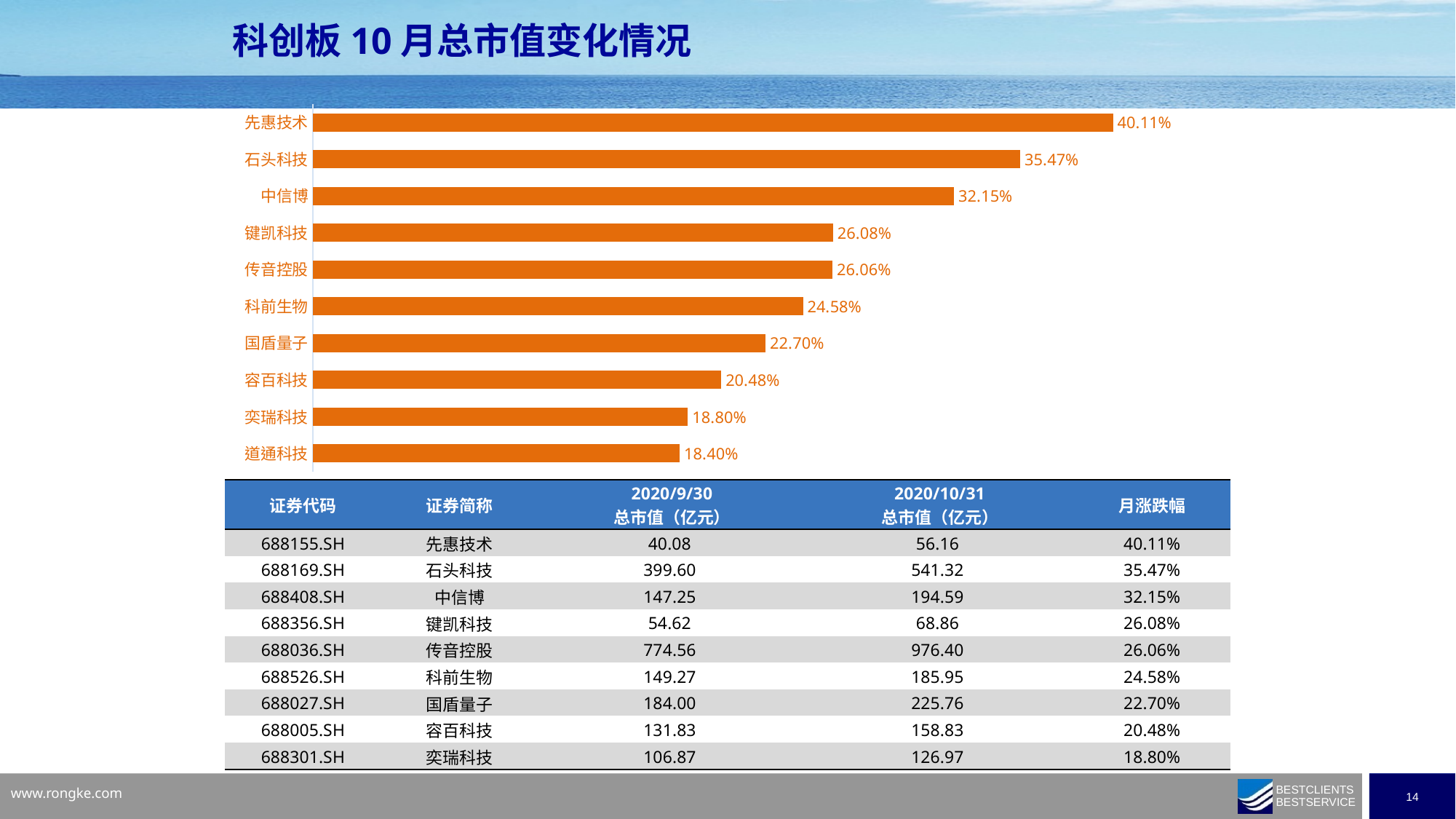
What is the title of the slide containing the bar chart? 科创板 10 月总市值变化情况 Which company has the highest value in the bar chart? 先惠技术 What is the difference between the values for 先惠技术 and 石头科技 in the bar chart? 4.64% What is the value shown for 道通科技 in the bar chart? 18.40% What is the difference between the values for 国盾量子 and 道通科技 in the bar chart? 4.30% What is the value shown for 先惠技术 in the bar chart? 40.11% What kind of chart is shown on the slide? bar chart Do the values in the bar chart rise or fall from the top bar to the bottom bar? fall Which has a larger value in the bar chart, 中信博 or 科前生物? 中信博 Which company has the lowest value in the bar chart? 道通科技 What is the value shown for 国盾量子 in the bar chart? 22.70% How many companies are shown in the bar chart? 10